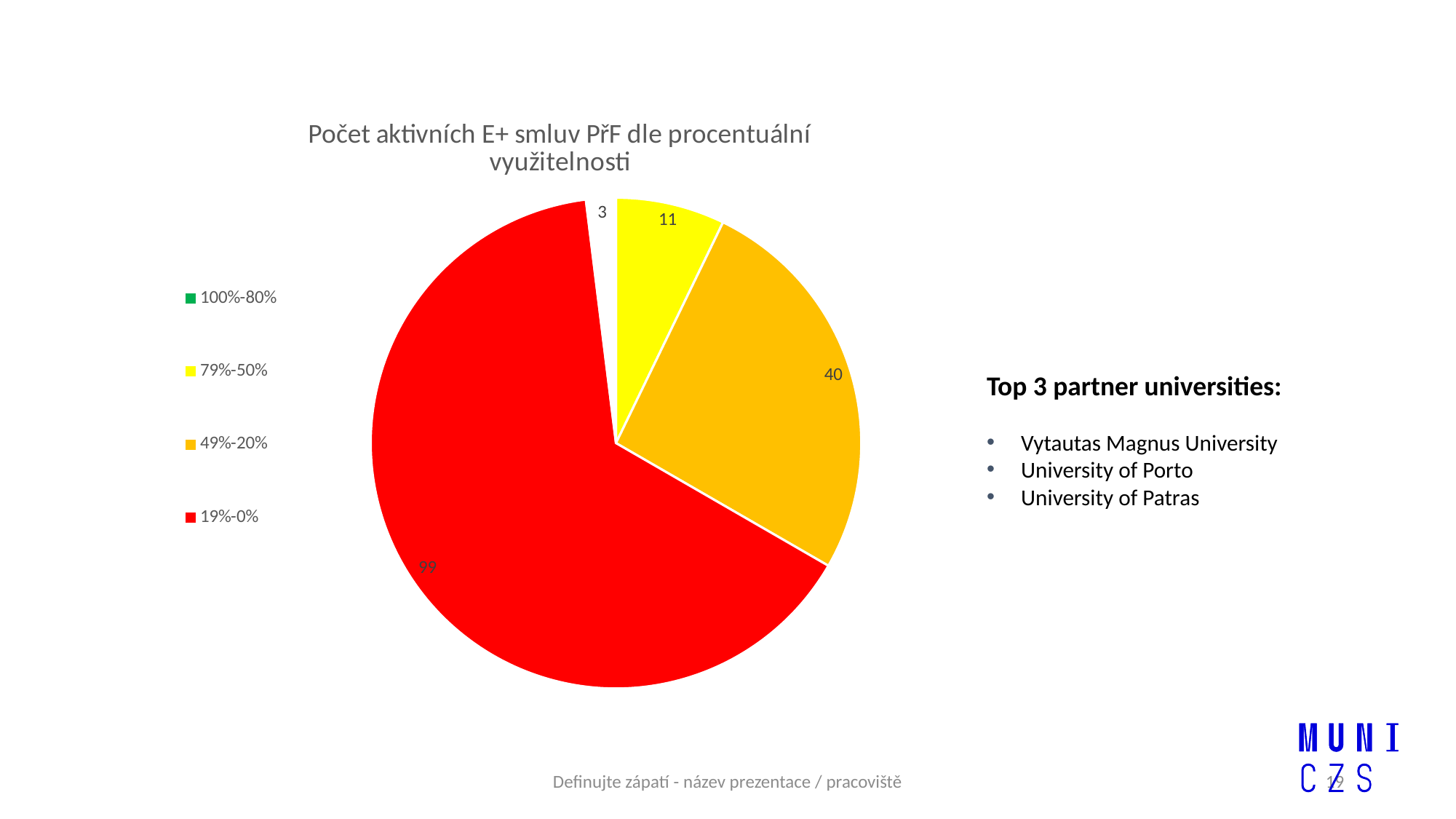
Which category has the largest slice of the pie? 19%-0% What is the value for the 49%-20% category? 40 What is the total of all the slice values in the pie chart? 153 Which is larger, the value for 79%-50% or the value for 49%-20%? 49%-20% What type of chart is shown on the slide? pie chart What is the difference between the values for 19%-0% and 49%-20%? 59 What is the value for the 79%-50% category? 11 What colour is the slice for the 19%-0% category? red What is the value for the 19%-0% category? 99